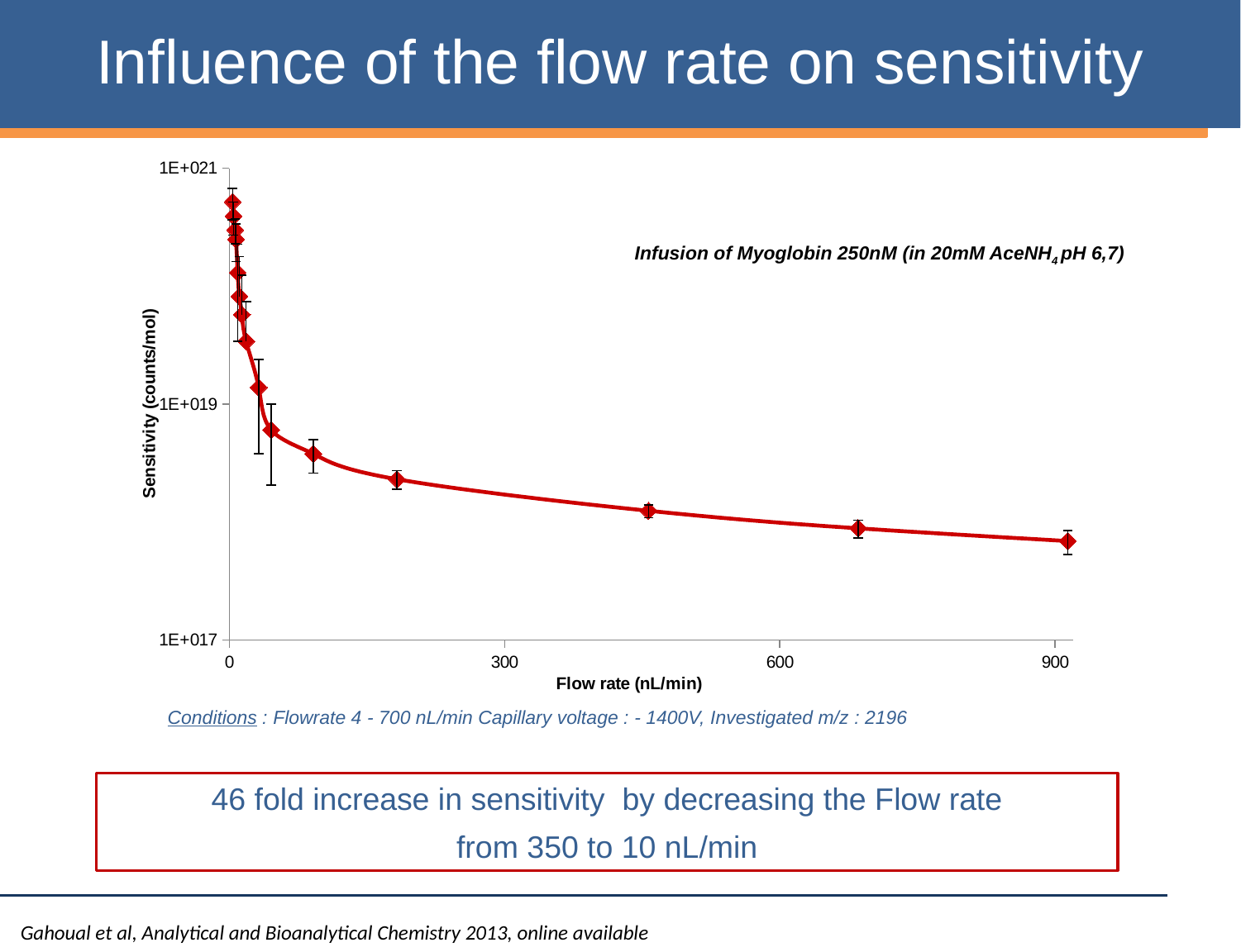
Is the sensitivity at the lowest flow rates (near 0 nL/min) greater or less than 1E+019? greater Which is larger: the sensitivity at the lowest flow rate or at the highest flow rate? at the lowest flow rate Is the sensitivity at the lowest flow rates (near 0 nL/min) greater or less than 1E+021? less At which end of the flow rate range is sensitivity highest? the lowest flow rates (near 0 nL/min) Is the sensitivity at the highest flow rate (around 900 nL/min) greater or less than 1E+017? greater What kind of chart is shown on the slide? line chart How does sensitivity change as the flow rate increases along the x axis? It falls What is the label of the y axis? Sensitivity (counts/mol) At which end of the flow rate range is sensitivity lowest? the highest flow rate (around 900 nL/min) What is the label of the x axis? Flow rate (nL/min) Which is larger: the sensitivity at a flow rate of about 450 nL/min or at about 900 nL/min? at about 450 nL/min